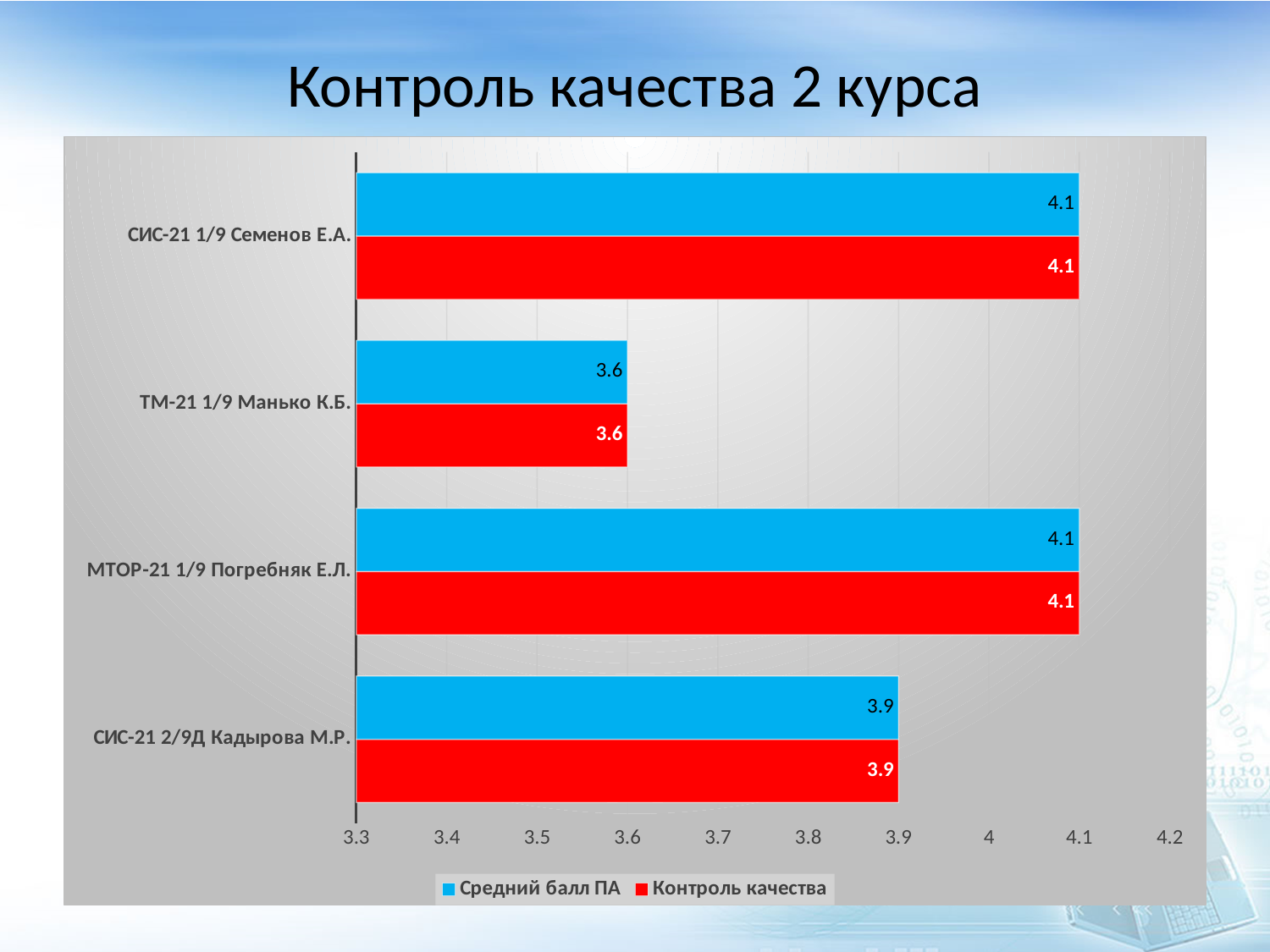
What is the value of Средний балл ПА for МТОР-21 1/9 Погребняк Е.Л.? 4.1 What kind of chart is shown on the slide? Bar chart Which is larger: the Средний балл ПА value for МТОР-21 1/9 Погребняк Е.Л. or for СИС-21 2/9Д Кадырова М.Р.? МТОР-21 1/9 Погребняк Е.Л. What is the value of Контроль качества for СИС-21 1/9 Семенов Е.А.? 4.1 How many series does the legend list? 2 What is the value of Контроль качества for СИС-21 2/9Д Кадырова М.Р.? 3.9 What is the difference between the Средний балл ПА values for СИС-21 2/9Д Кадырова М.Р. and ТМ-21 1/9 Манько К.Б.? 0.3 What is the value of Средний балл ПА for ТМ-21 1/9 Манько К.Б.? 3.6 What is the difference between the Контроль качества values for СИС-21 1/9 Семенов Е.А. and ТМ-21 1/9 Манько К.Б.? 0.5 Which category has the lowest value for Средний балл ПА? ТМ-21 1/9 Манько К.Б. How many categories are shown on the chart? 4 What colour represents the Контроль качества series? Red